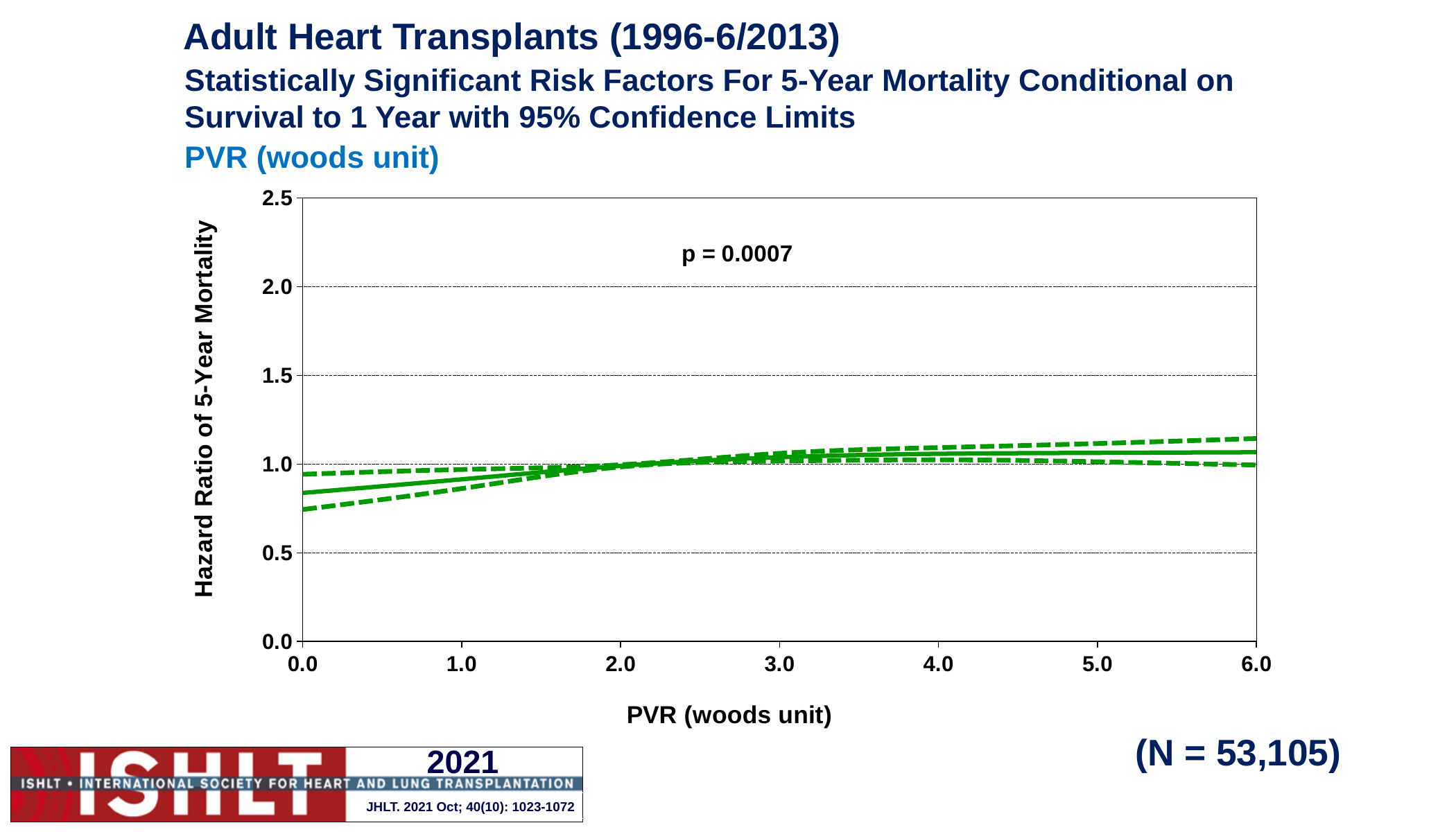
What is the highest value shown on the x-axis of the chart? 6.0 What is the highest value shown on the y-axis of the chart? 2.5 What kind of chart is shown on the slide? line chart What is the label of the y-axis of the chart? Hazard Ratio of 5-Year Mortality Is the hazard ratio (solid line) at a PVR of 6.0 woods units greater or less than 1.0? greater What p-value is printed on the chart? p = 0.0007 Is the hazard ratio (solid line) at a PVR of 3.0 woods units greater or less than 1.5? less Is the hazard ratio (solid line) at a PVR of 0.0 woods units greater or less than 1.0? less How many lines are plotted on the chart (including the confidence limits)? 3 Does the solid hazard ratio line rise or fall as PVR increases from 0.0 to 6.0 woods units? rise